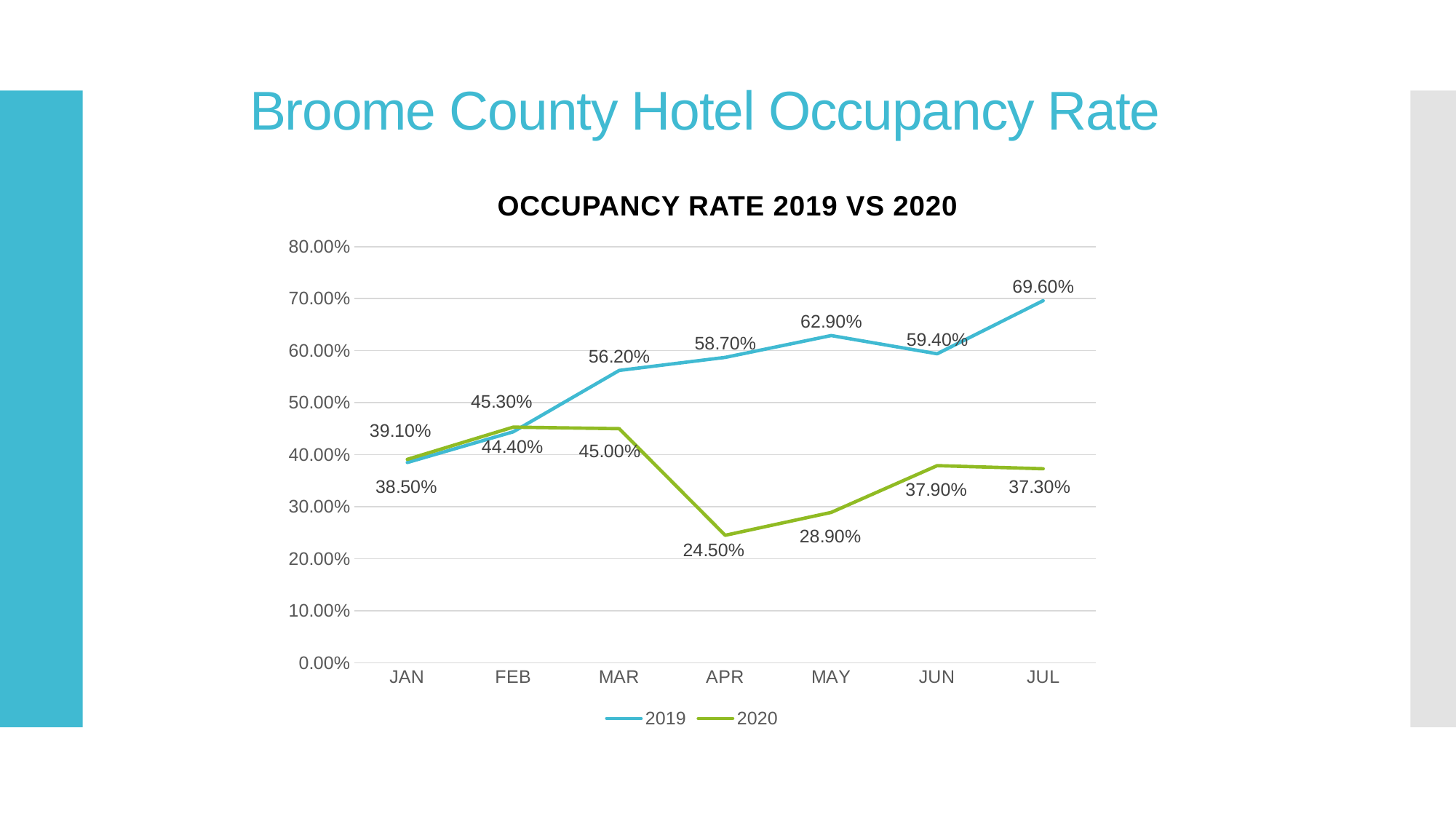
How many series does the legend list? 2 What is the difference between the 2019 and 2020 occupancy rates in MAY? 34.00% What is the 2019 occupancy rate for JUL? 69.60% What is the 2020 occupancy rate for JUN? 37.90% What kind of chart is shown on the slide? Line chart Which series has the higher occupancy rate in FEB, 2019 or 2020? 2020 What is the 2020 occupancy rate for APR? 24.50% What is the difference between the 2019 and 2020 occupancy rates in JUL? 32.30% How many months are plotted along the x axis? 7 In which month is the 2020 occupancy rate lowest? APR Is the 2019 value for MAY greater or less than 60.00%? greater In which month is the 2019 occupancy rate highest? JUL